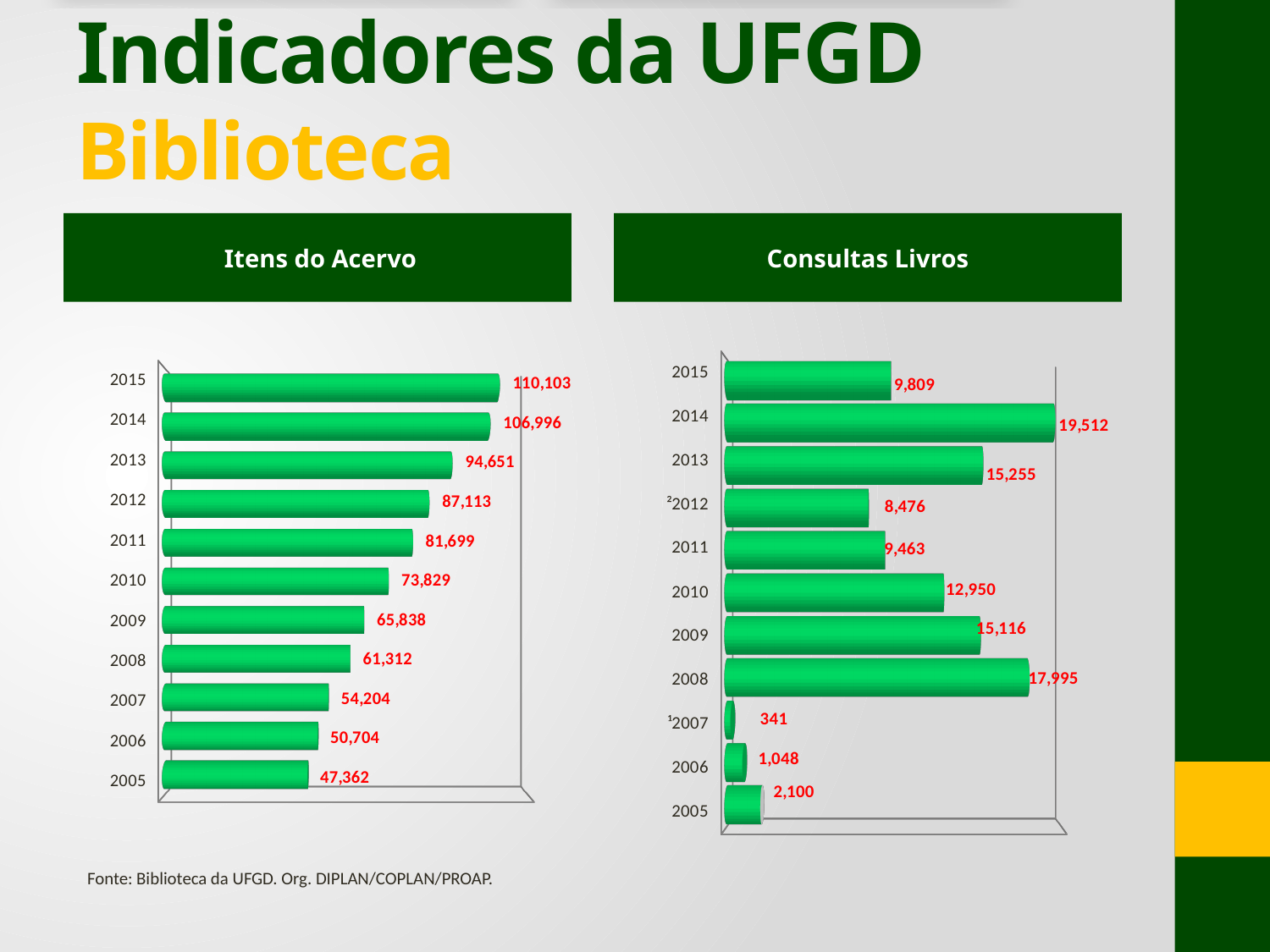
In the 'Consultas Livros' chart, which year has the lowest value? 2007 In the 'Consultas Livros' chart, what is the difference between the values for 2014 and 2008? 1,517 In the 'Consultas Livros' chart, which is larger, the value for 2010 or the value for 2011? 2010 In the 'Itens do Acervo' chart, which year has the highest value? 2015 In the 'Consultas Livros' chart, which year has the highest value? 2014 What kind of chart is the 'Itens do Acervo' chart? Bar chart In the 'Itens do Acervo' chart, what is the value for 2013? 94,651 In the 'Consultas Livros' chart, what is the value for 2007? 341 In the 'Itens do Acervo' chart, what is the difference between the values for 2015 and 2014? 3,107 In the 'Consultas Livros' chart, what is the value for 2010? 12,950 How many years are shown in the 'Itens do Acervo' chart? 11 In the 'Itens do Acervo' chart, do the values rise or fall from 2005 to 2015? Rise